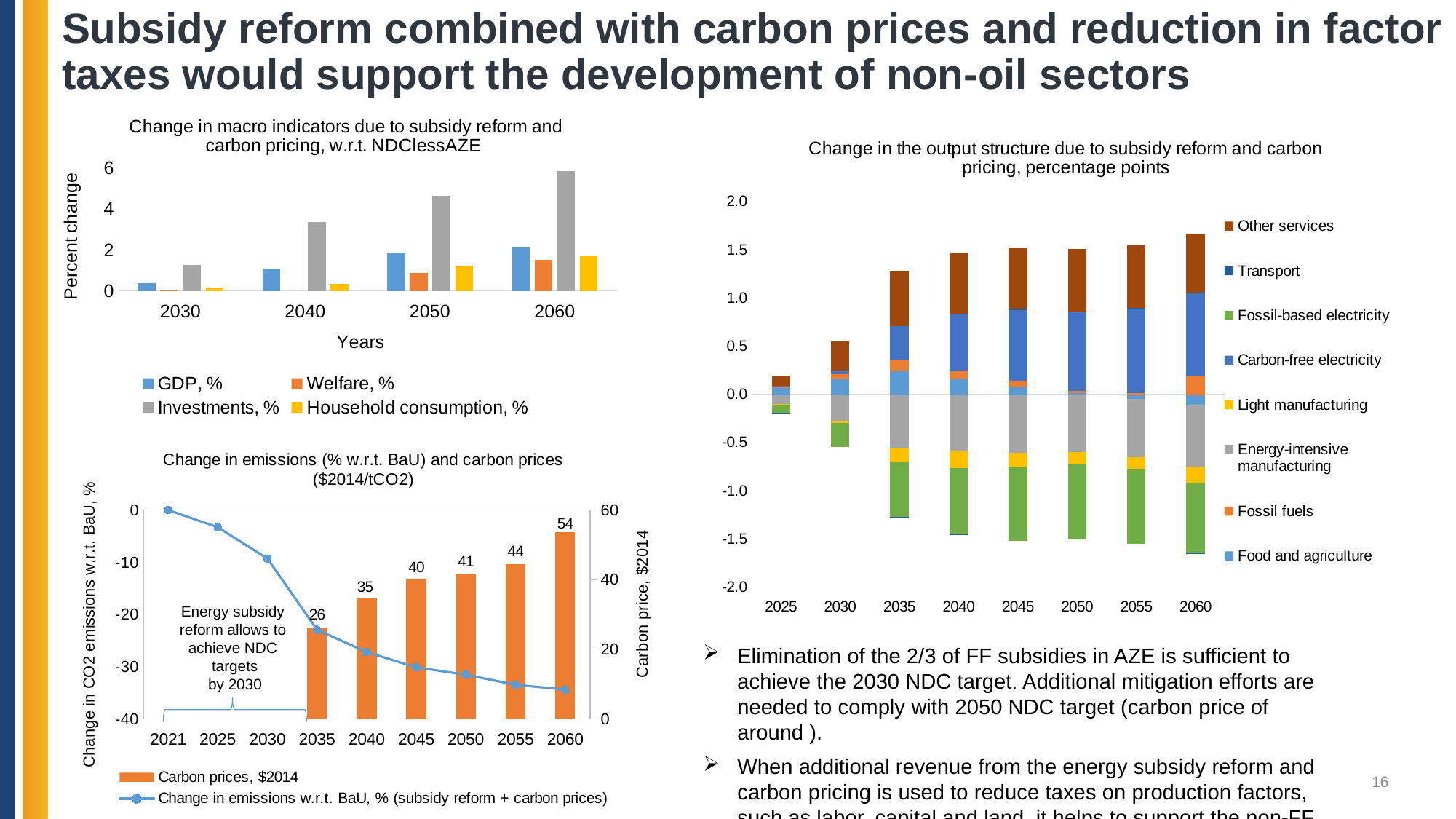
In the chart titled 'Change in the output structure due to subsidy reform and carbon pricing, percentage points', how many years are shown on the x axis? 8 In the chart titled 'Change in macro indicators due to subsidy reform and carbon pricing, w.r.t. NDClessAZE', which is larger in 2050: GDP or Welfare? GDP, % In the chart titled 'Change in emissions (% w.r.t. BaU) and carbon prices ($2014/tCO2)', how many series does the legend list? 2 In the chart titled 'Change in emissions (% w.r.t. BaU) and carbon prices ($2014/tCO2)', what is the difference between the carbon price in 2060 and in 2035? 28 In the chart titled 'Change in emissions (% w.r.t. BaU) and carbon prices ($2014/tCO2)', does the change in emissions line rise or fall from 2021 to 2060? fall In the chart titled 'Change in macro indicators due to subsidy reform and carbon pricing, w.r.t. NDClessAZE', is the value for Investments in 2060 greater or less than 4? greater In the chart titled 'Change in emissions (% w.r.t. BaU) and carbon prices ($2014/tCO2)', what is the carbon price in 2060? 54 In the chart titled 'Change in macro indicators due to subsidy reform and carbon pricing, w.r.t. NDClessAZE', how many series does the legend list? 4 In the chart titled 'Change in emissions (% w.r.t. BaU) and carbon prices ($2014/tCO2)', which year has the highest carbon price? 2060 In the chart titled 'Change in macro indicators due to subsidy reform and carbon pricing, w.r.t. NDClessAZE', which indicator has the highest value in 2060? Investments, % What kind of chart is the one titled 'Change in the output structure due to subsidy reform and carbon pricing, percentage points'? stacked bar chart In the chart titled 'Change in emissions (% w.r.t. BaU) and carbon prices ($2014/tCO2)', what is the carbon price in 2035? 26